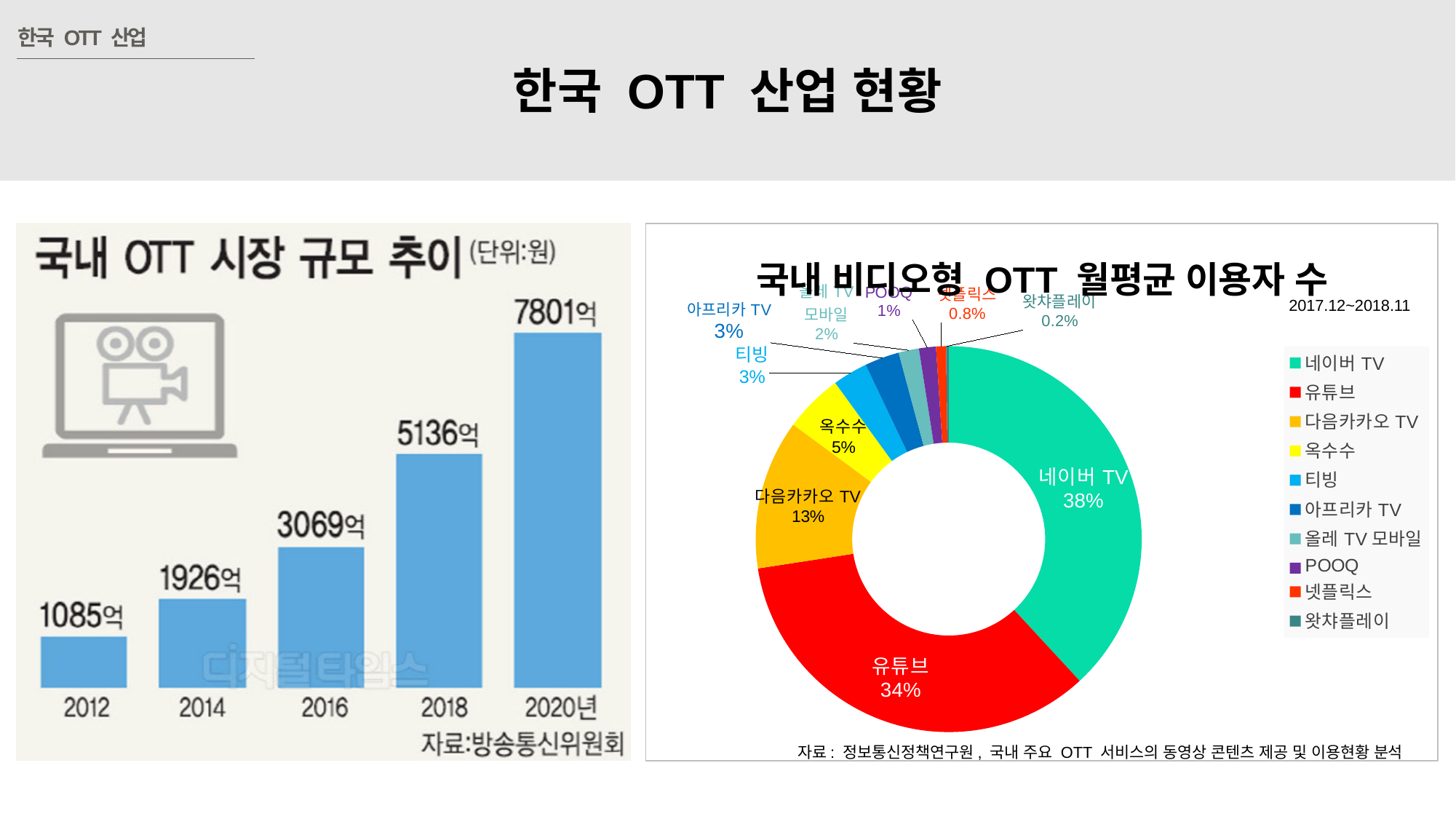
In the right chart '국내 비디오형 OTT 월평균 이용자 수', which service has the largest share? 네이버 TV In the left chart '국내 OTT 시장 규모 추이', do the values rise or fall from 2012 to 2020? rise In the left chart '국내 OTT 시장 규모 추이', what is the value for 2020년? 7801억 In the right chart '국내 비디오형 OTT 월평균 이용자 수', what share does 다음카카오 TV have? 13% In the right chart '국내 비디오형 OTT 월평균 이용자 수', which service has the smallest share? 왓챠플레이 In the left chart '국내 OTT 시장 규모 추이', which year has the lowest value? 2012 In the left chart '국내 OTT 시장 규모 추이', what is the difference between the 2018 and 2014 values? 3210억 In the left chart '국내 OTT 시장 규모 추이', how many years are shown on the x axis? 5 In the right chart '국내 비디오형 OTT 월평균 이용자 수', which is larger, the share of 유튜브 or the share of 옥수수? 유튜브 What kind of chart is the left chart '국내 OTT 시장 규모 추이'? bar chart In the right chart '국내 비디오형 OTT 월평균 이용자 수', how many services does the legend list? 10 In the left chart '국내 OTT 시장 규모 추이', what is the value for 2016? 3069억